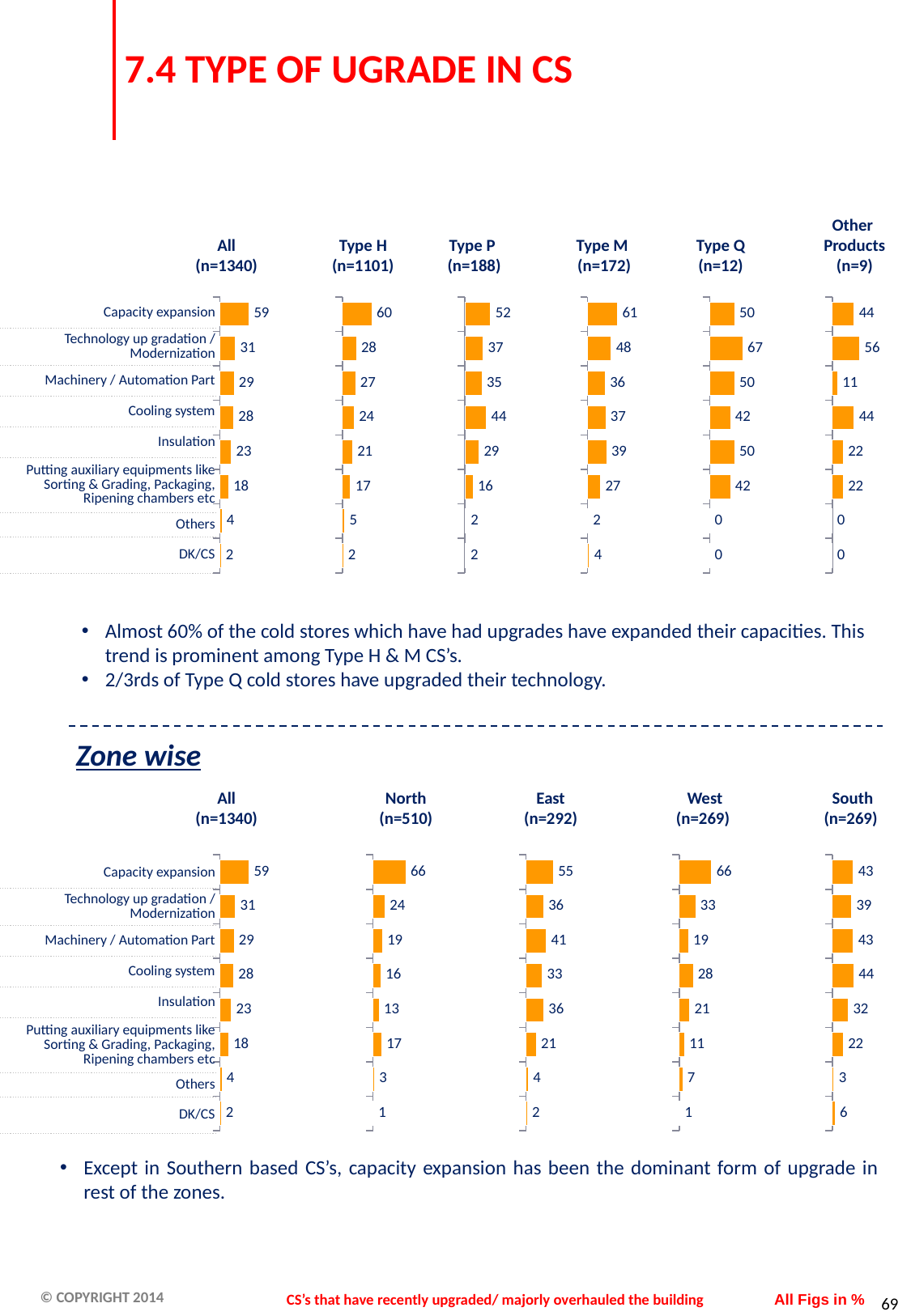
What type of chart is used for the All (n=1340) chart in the top set? Bar chart In the Zone wise charts, which is larger: Insulation for West (n=269) or Insulation for East (n=292)? East (36) In the top set of charts (by type), what is the value for Technology up gradation / Modernization in the Type Q (n=12) chart? 67 In the top set of charts (by type), what is the difference between Capacity expansion in the Type H (n=1101) chart and Capacity expansion in the Type P (n=188) chart? 8 How many categories are plotted in each of the Zone wise charts? 8 In the top set of charts (by type), which category has the lowest value in the Other Products (n=9) chart? Others and DK/CS (both 0) In the Zone wise charts, which category has the highest value in the South (n=269) chart? Cooling system In the top set of charts (by type), what is the value for Capacity expansion in the Type M (n=172) chart? 61 In the Zone wise charts, what is the value for Machinery / Automation Part in the East (n=292) chart? 41 In the Zone wise charts, what is the difference between Capacity expansion in the North (n=510) chart and Capacity expansion in the South (n=269) chart? 23 In the top set of charts (by type), which category has the highest value in the Type P (n=188) chart? Capacity expansion In the top set of charts (by type), which is larger: Cooling system for Type P (n=188) or Cooling system for Type M (n=172)? Type P (44)